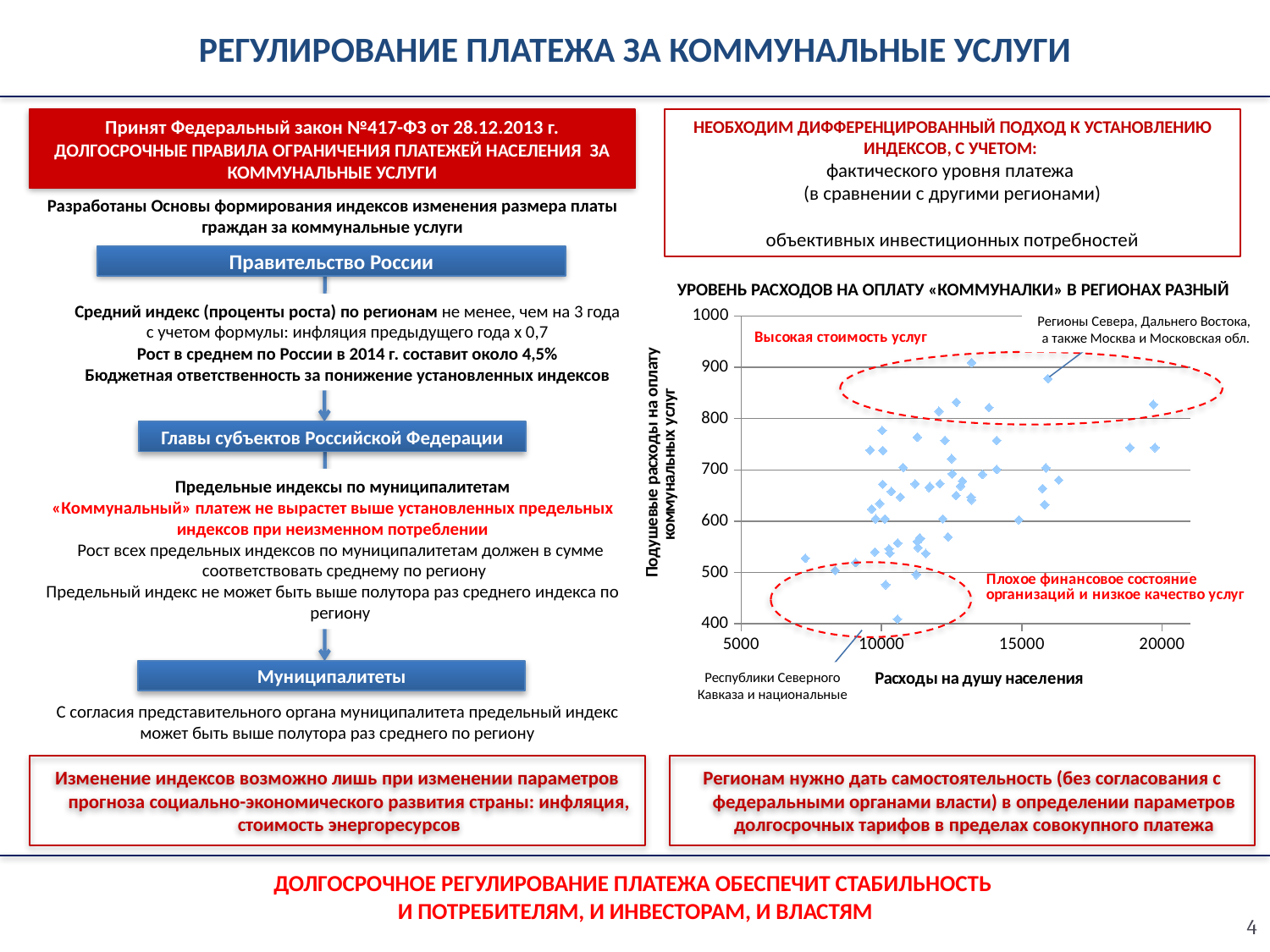
In the scatter chart, is the point with the largest horizontal-axis value greater or less than 15000 on the horizontal axis? greater What kind of chart is shown under the heading «УРОВЕНЬ РАСХОДОВ НА ОПЛАТУ «КОММУНАЛКИ» В РЕГИОНАХ РАЗНЫЙ»? Scatter chart In the scatter chart, is the highest plotted point greater or less than 800 on the vertical axis? greater In the scatter chart, is the highest plotted point greater or less than 1000 on the vertical axis? less What is the label of the horizontal axis of the scatter chart? Расходы на душу населения What is the label of the vertical axis of the scatter chart? Подушевые расходы на оплату коммунальных услуг